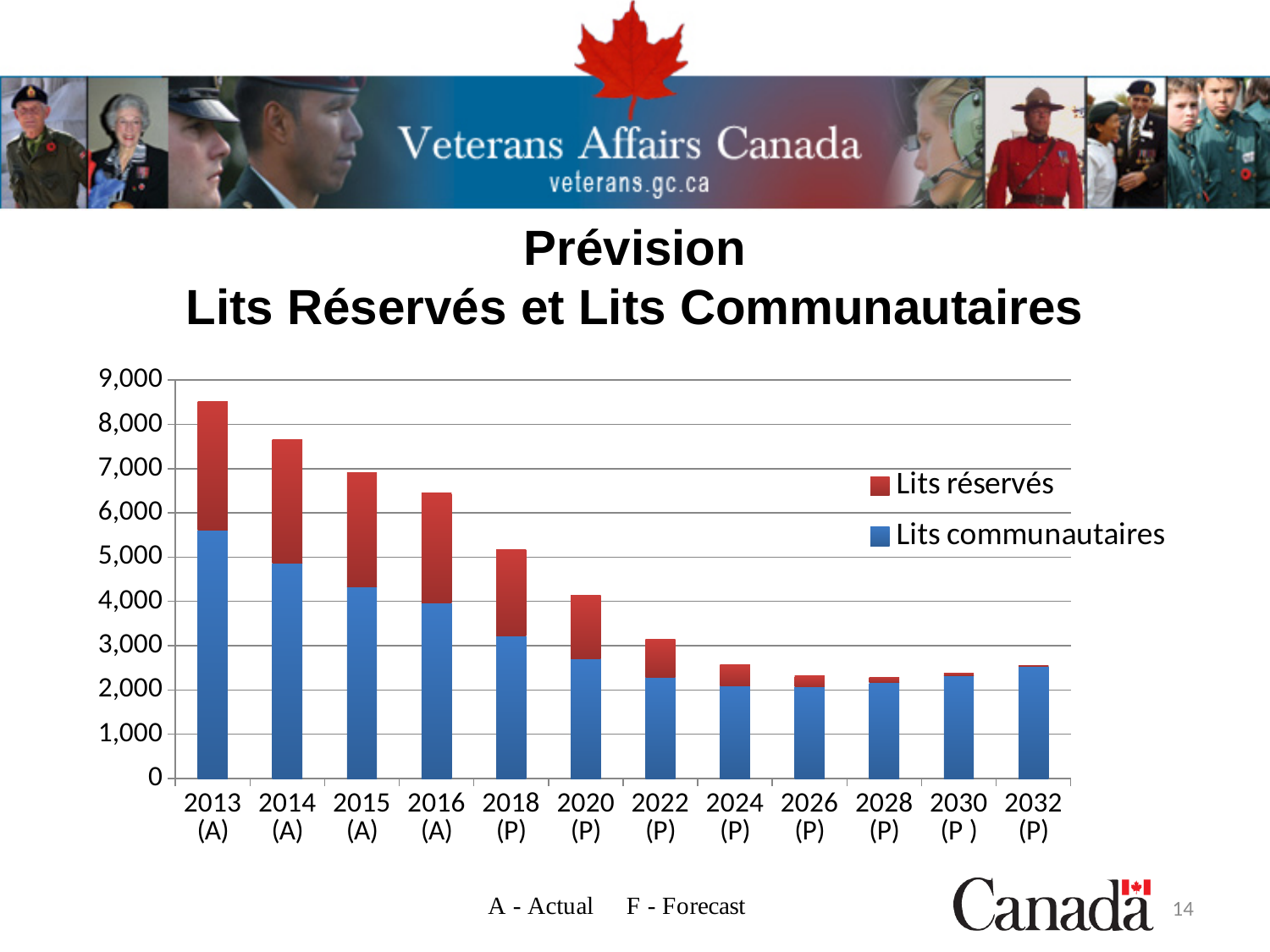
Is the total bar for 2026 (P) greater or less than 3,000? less Is the value for Lits communautaires in 2013 (A) greater or less than 5,000? greater Do the total bars generally rise or fall from 2013 (A) to 2026 (P)? fall Which year has the highest total number of beds (Lits réservés plus Lits communautaires)? 2013 (A) Which colour represents Lits réservés in the legend? Red Which is larger, the total bar for 2013 (A) or the total bar for 2014 (A)? 2013 (A) How many series does the legend list? 2 What kind of chart is shown on the slide? Stacked bar chart Which year has the highest value for Lits communautaires? 2013 (A) How many year categories are shown on the x axis? 12 Is the total bar for 2013 (A) greater or less than 8,000? greater